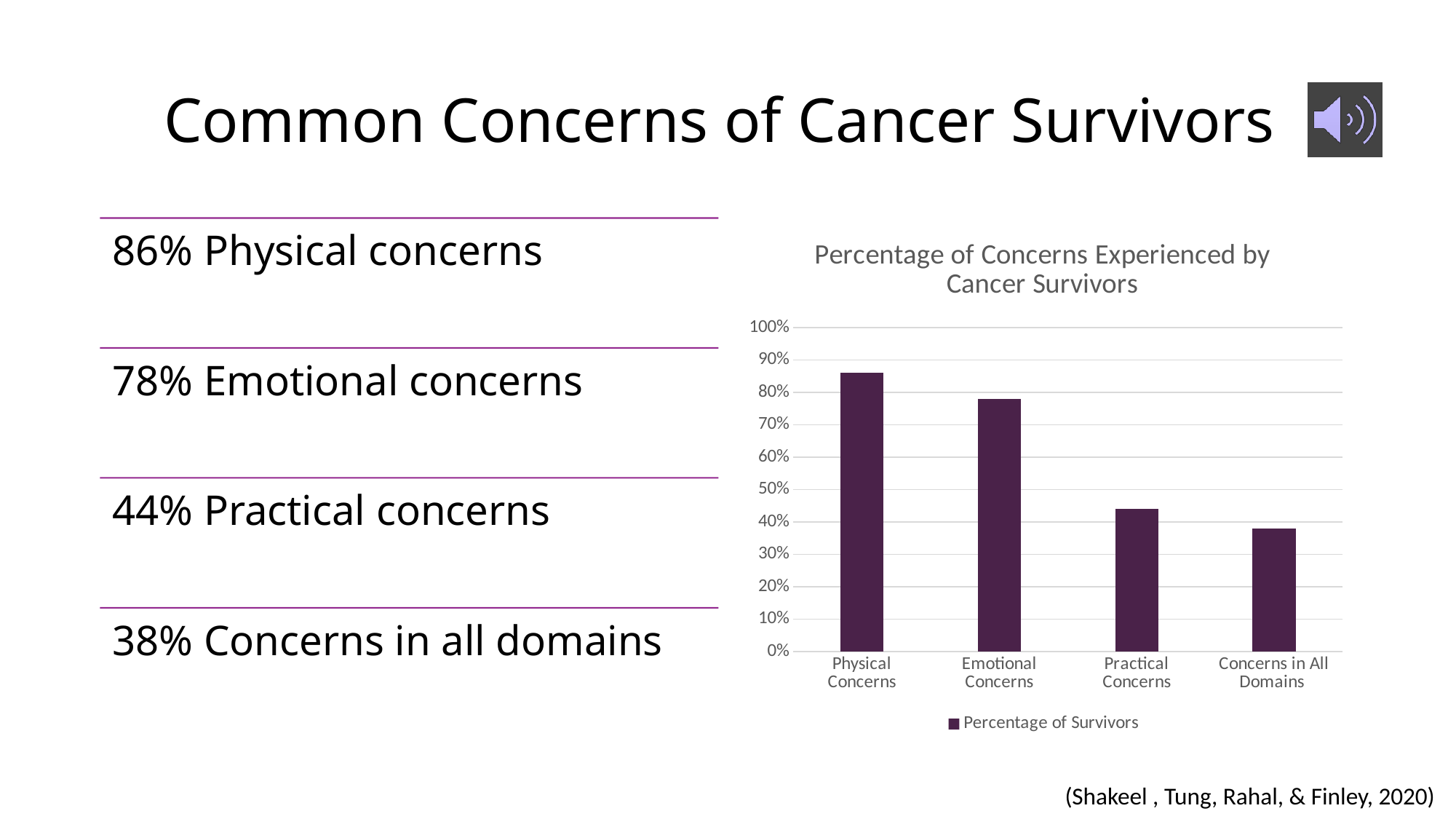
What is the value for Emotional Concerns? 78% What is the difference between the values for Physical Concerns and Emotional Concerns? 8% What type of chart is shown on the slide? Bar chart Which category has the lowest value? Concerns in All Domains Do the values rise or fall from left to right across the categories? Fall How many categories are plotted in the chart? 4 Which category has the highest value? Physical Concerns What is the value for Physical Concerns? 86% Is the value for Concerns in All Domains greater or less than 40%? less What is the title of the chart? Percentage of Concerns Experienced by Cancer Survivors What is the value for Practical Concerns? 44% How many series does the chart legend list? 1